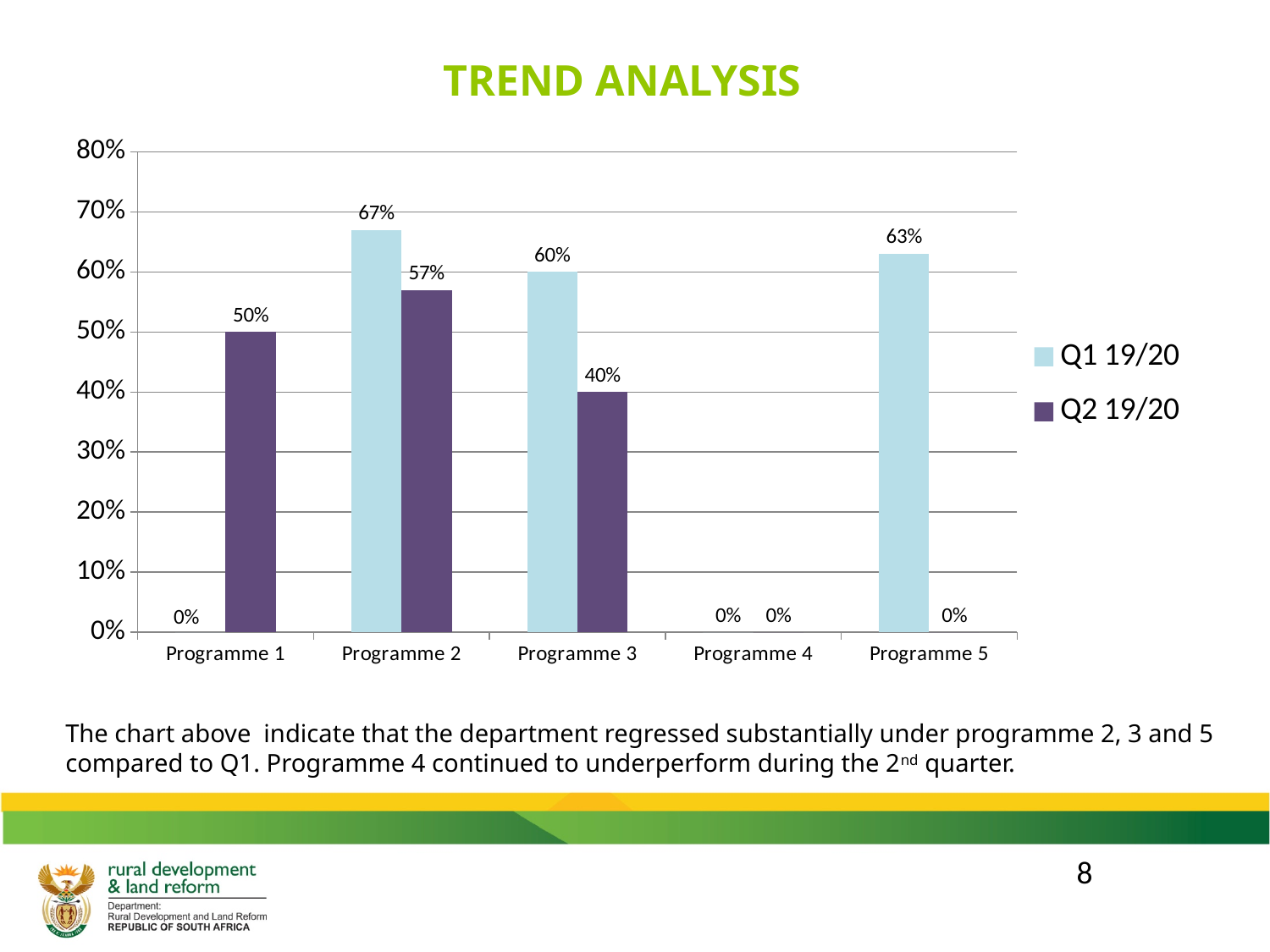
What is the Q1 19/20 value for Programme 2? 67% Which programme has the highest Q2 19/20 value? Programme 2 How many series does the legend list? 2 What is the Q2 19/20 value for Programme 1? 50% What kind of chart is shown on the slide? Bar chart What is the Q1 19/20 value for Programme 5? 63% How many programmes are shown on the x axis? 5 Which is larger for Programme 5: the Q1 19/20 value or the Q2 19/20 value? Q1 19/20 Which programme has the highest Q1 19/20 value? Programme 2 What is the difference between the Q1 19/20 and Q2 19/20 values for Programme 2? 10% What is the Q2 19/20 value for Programme 3? 40% What is the difference between the Q1 19/20 and Q2 19/20 values for Programme 3? 20%